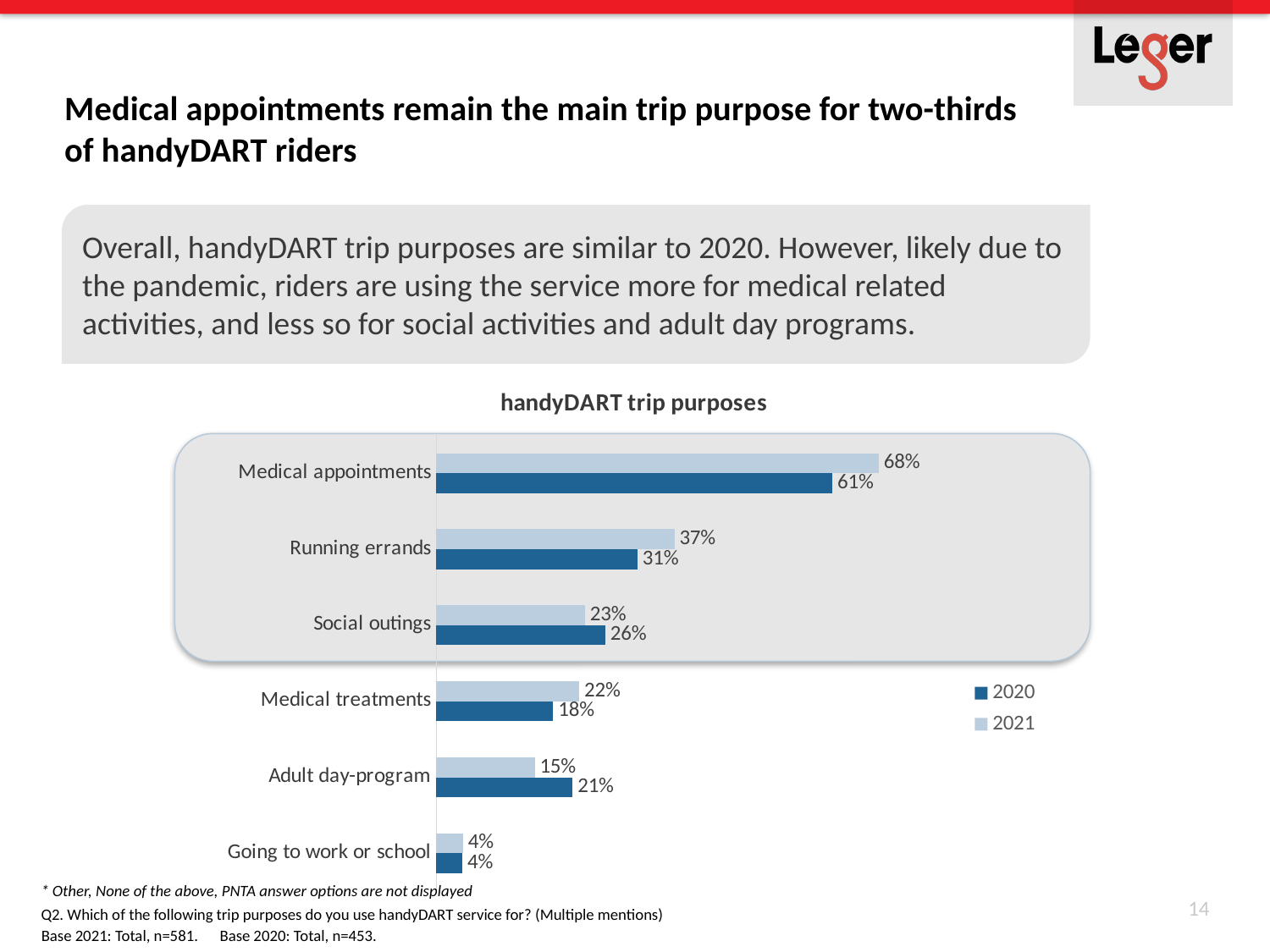
What is the 2021 value for Medical appointments? 68% For Social outings, which year has the larger value, 2020 or 2021? 2020 What type of chart is shown on the slide? Bar chart How many series does the legend list? 2 How many trip purpose categories are shown in the chart? 6 What is the difference between the 2021 and 2020 values for Medical appointments? 7% For Medical treatments, which year has the larger value, 2020 or 2021? 2021 Which trip purpose has the lowest 2020 value? Going to work or school What is the 2021 value for Adult day-program? 15% What is the 2020 value for Running errands? 31% Which trip purpose has the highest 2021 value? Medical appointments What is the difference between the 2020 and 2021 values for Adult day-program? 6%